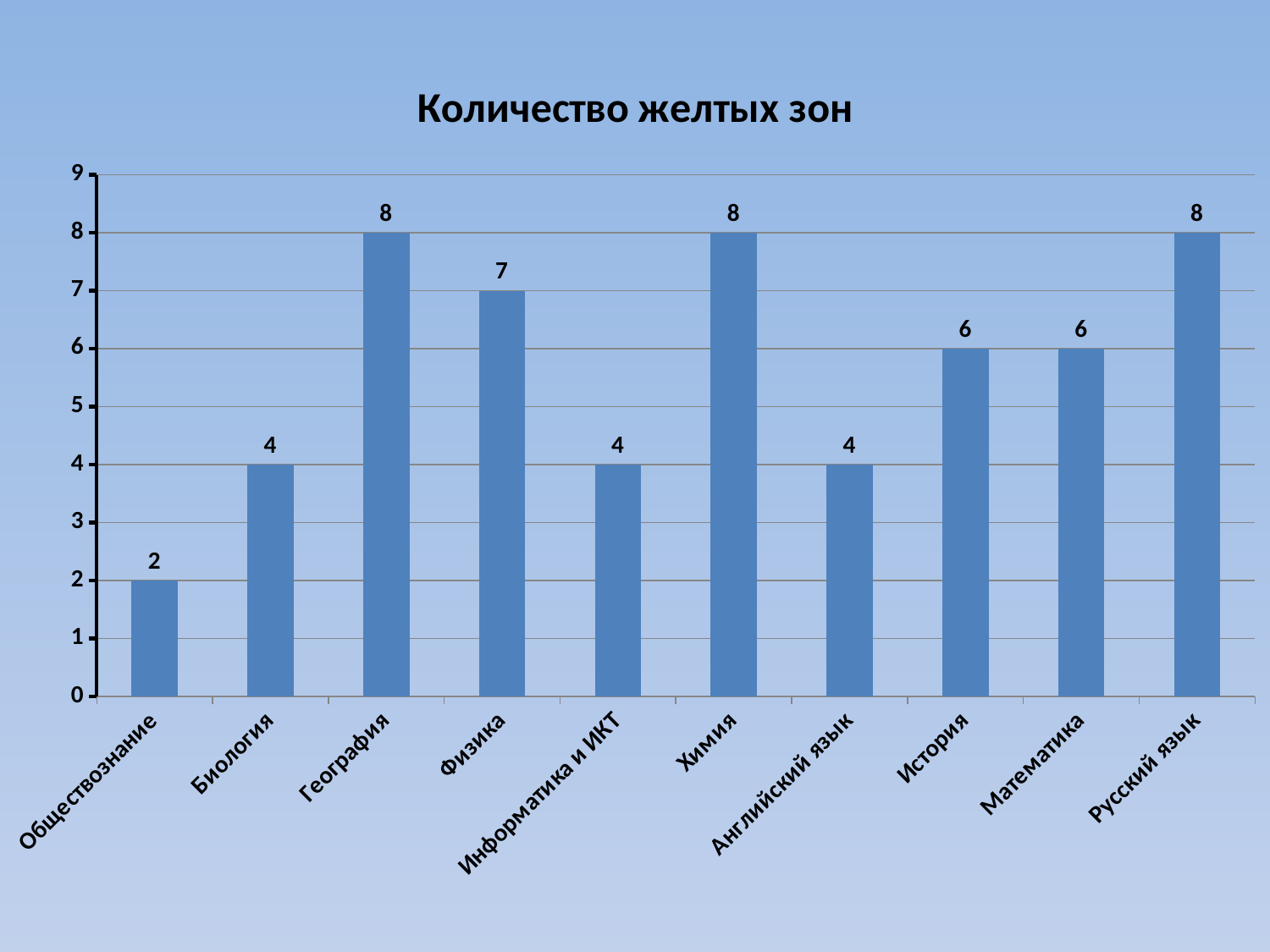
What is the value for История? 6 What is the difference between the values for Физика and Математика? 1 What kind of chart is shown on the slide? bar chart Which category has the lowest value? Обществознание What is the difference between the values for География and Биология? 4 What is the value for Английский язык? 4 What is the value for Физика? 7 Which is larger, the value for Химия or the value for Информатика и ИКТ? Химия How many categories are shown on the chart? 10 What is the title of the chart? Количество желтых зон What is the value for Обществознание? 2 Is the value for Русский язык greater or less than 5? greater